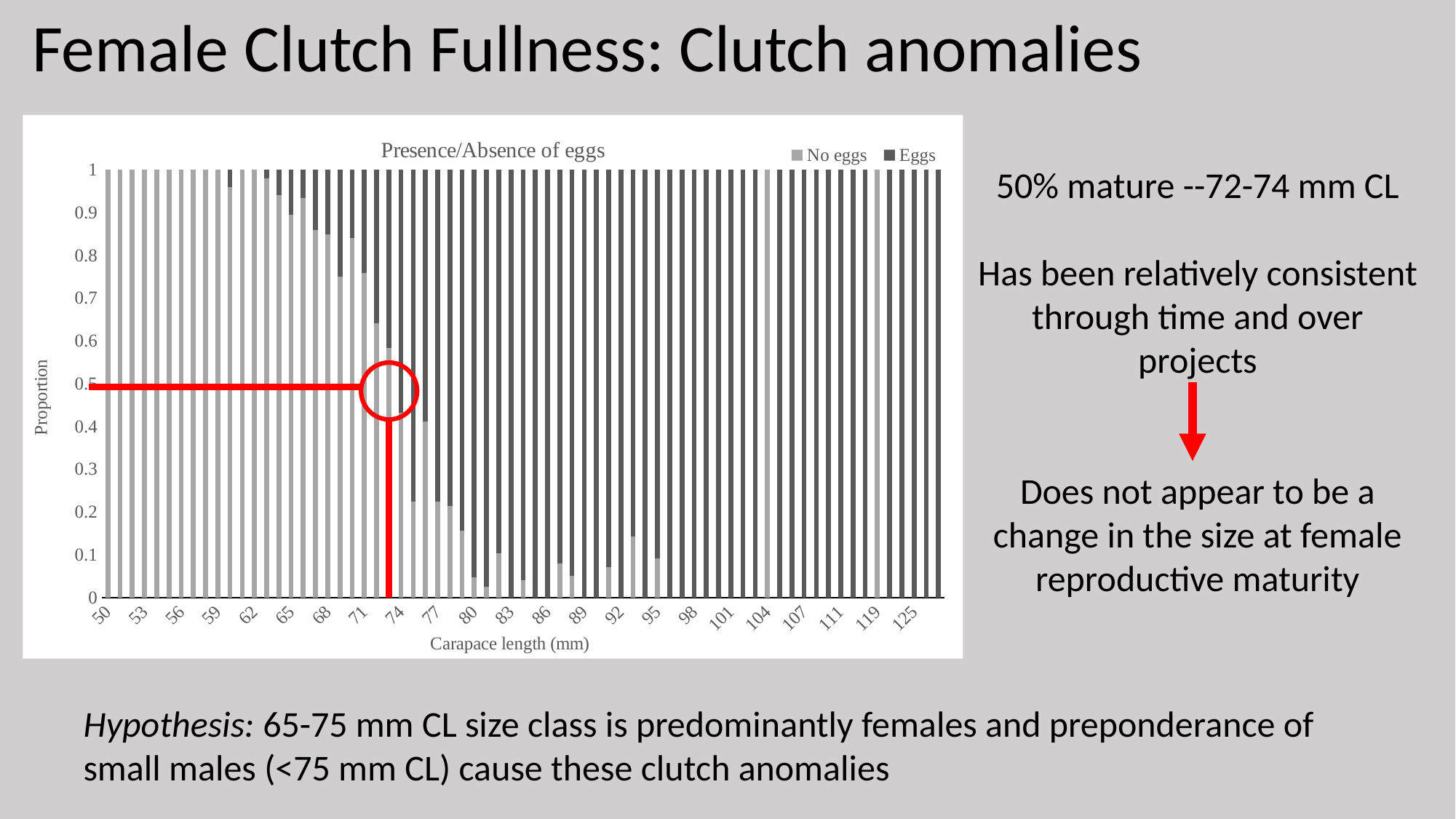
As carapace length increases along the x axis, does the proportion of 'No eggs' rise or fall? Fall Is the 'Eggs' proportion at 50 mm carapace length greater or less than 0.1? less How many series does the chart's legend list? 2 Is the 'No eggs' proportion at 80 mm carapace length greater or less than 0.1? less At 98 mm carapace length, which series has the larger proportion, 'No eggs' or 'Eggs'? Eggs What kind of chart is shown on the slide? Stacked bar chart Is the 'Eggs' proportion at 98 mm carapace length greater or less than 0.9? greater What are the two series named in the chart's legend? No eggs and Eggs At 50 mm carapace length, which series has the larger proportion, 'No eggs' or 'Eggs'? No eggs What is the title of the chart? Presence/Absence of eggs What is the total height of the stacked bar at 50 mm carapace length? 1